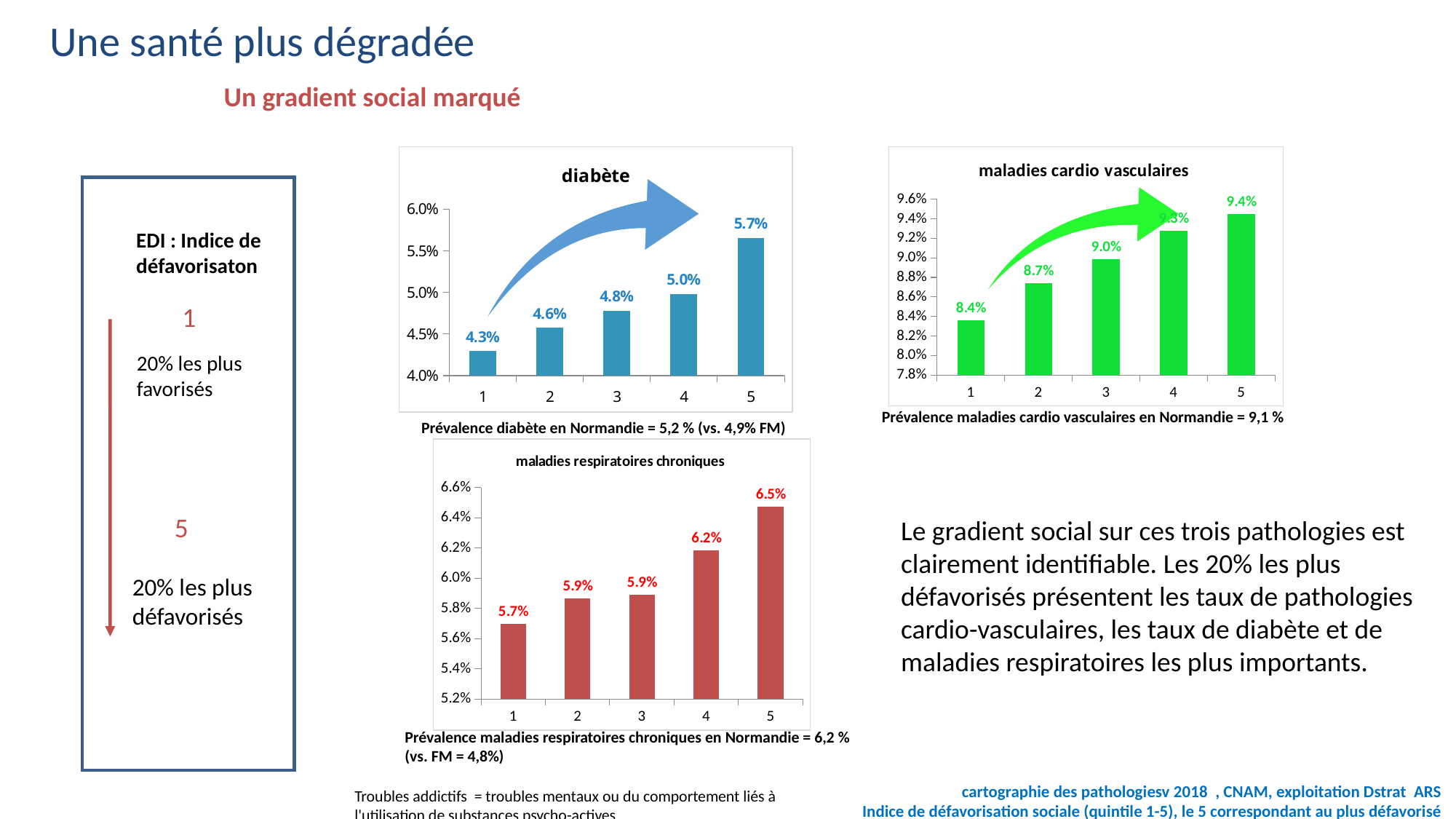
In the "maladies cardio vasculaires" chart, what is the value for category 3? 9.0% In the "diabète" chart, what is the value for category 1? 4.3% In the "diabète" chart, what is the difference between the values for category 5 and category 1? 1.4% In the "maladies respiratoires chroniques" chart, is the value for category 5 greater or less than 6.4%? greater How many categories are shown on the x axis of the "maladies respiratoires chroniques" chart? 5 In the "maladies cardio vasculaires" chart, what is the value for category 1? 8.4% In the "maladies respiratoires chroniques" chart, which category has the lowest value? 1 In the "maladies respiratoires chroniques" chart, what is the value for category 4? 6.2% What type of chart is the "maladies cardio vasculaires" chart? bar chart In the "maladies cardio vasculaires" chart, which category has the highest value? 5 In the "diabète" chart, what is the value for category 5? 5.7% In the "diabète" chart, do the values rise or fall from category 1 to category 5? rise